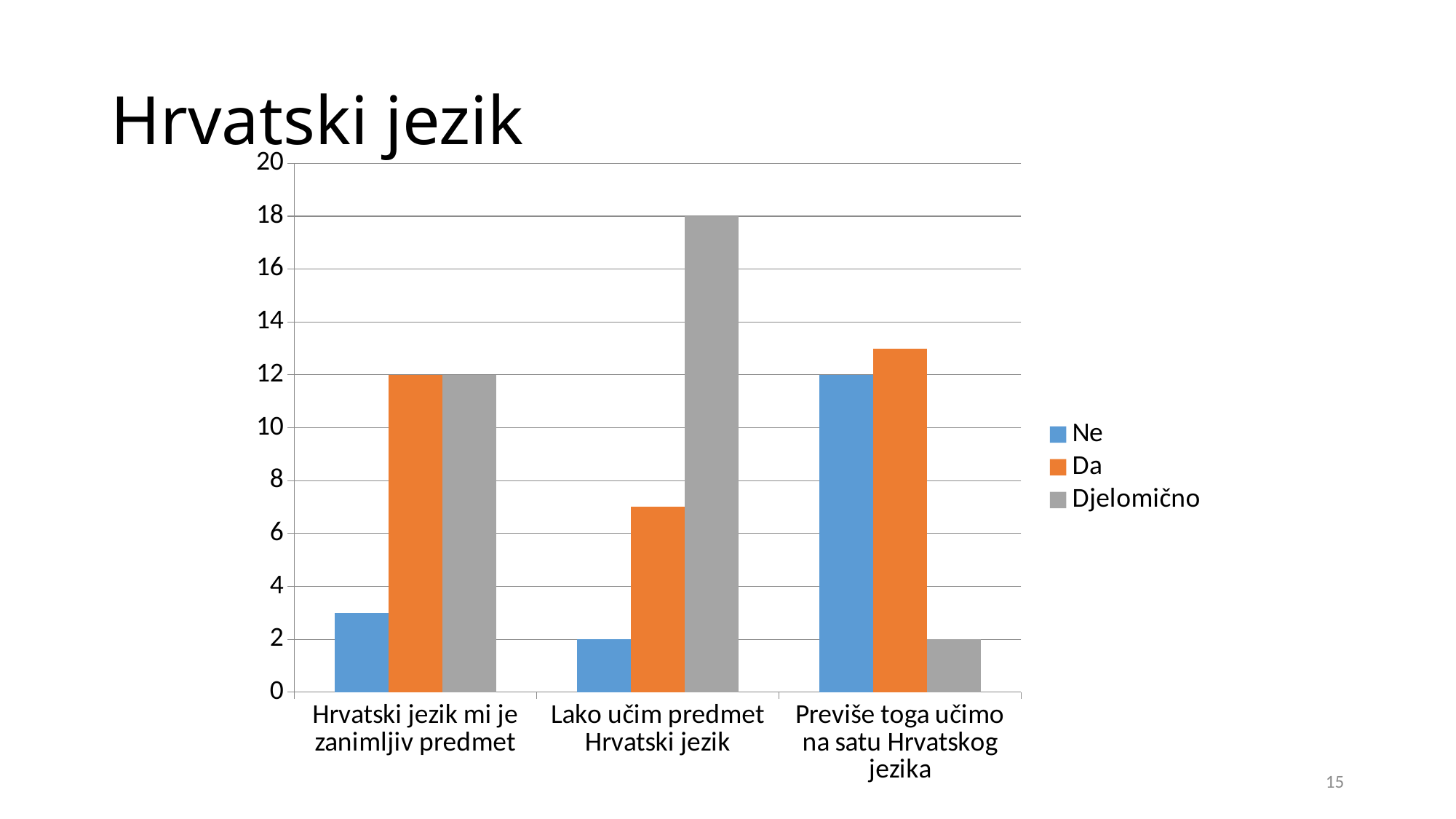
What is the value of Ne for "Previše toga učimo na satu Hrvatskog jezika"? 12 Which series has the lowest value for "Previše toga učimo na satu Hrvatskog jezika"? Djelomično What is the value of Djelomično for "Lako učim predmet Hrvatski jezik"? 18 Is the value of Da for "Lako učim predmet Hrvatski jezik" greater or less than 6? greater What is the value of Da for "Hrvatski jezik mi je zanimljiv predmet"? 12 Which series has the highest value for "Lako učim predmet Hrvatski jezik"? Djelomično What is the difference between the Djelomično value and the Ne value for "Lako učim predmet Hrvatski jezik"? 16 Is the value of Ne for "Hrvatski jezik mi je zanimljiv predmet" greater or less than 4? less What type of chart is shown on the slide? bar chart How many series does the legend list? 3 How many categories are shown on the x axis? 3 What is the value of Djelomično for "Previše toga učimo na satu Hrvatskog jezika"? 2